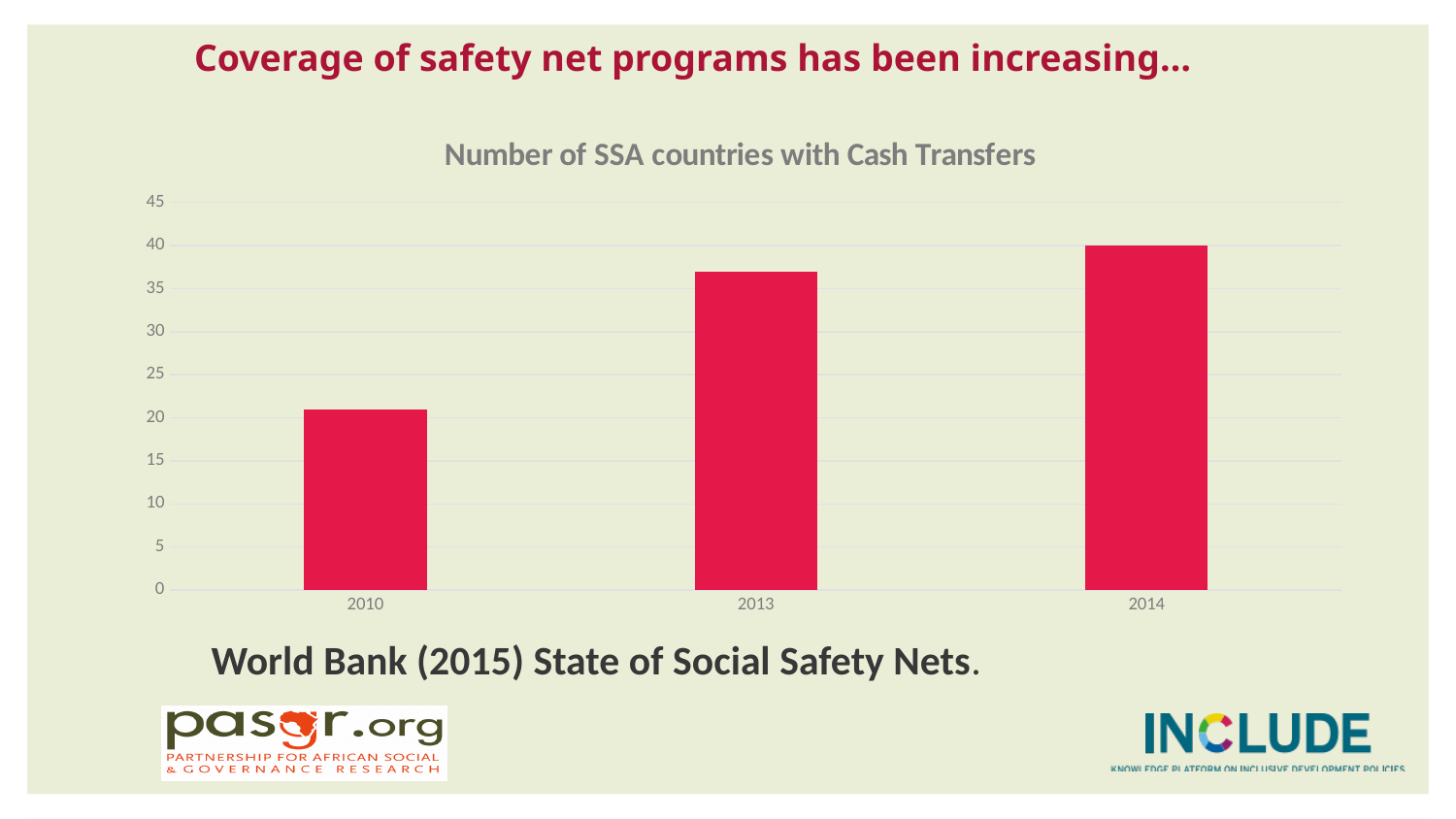
Is the value for 2010 greater or less than 25? less Which is larger, the value for 2010 or the value for 2013? 2013 What is the number of SSA countries with cash transfers in 2014? 40 What is the title of the chart? Number of SSA countries with Cash Transfers Which year has the lowest number of SSA countries with cash transfers? 2010 Is the value for 2013 greater or less than 35? greater Is the value for 2013 greater or less than 40? less Which year has the highest number of SSA countries with cash transfers? 2014 How many years are shown on the x axis of the chart? 3 Do the values rise or fall from 2010 to 2014? rise What kind of chart is shown on the slide? bar chart